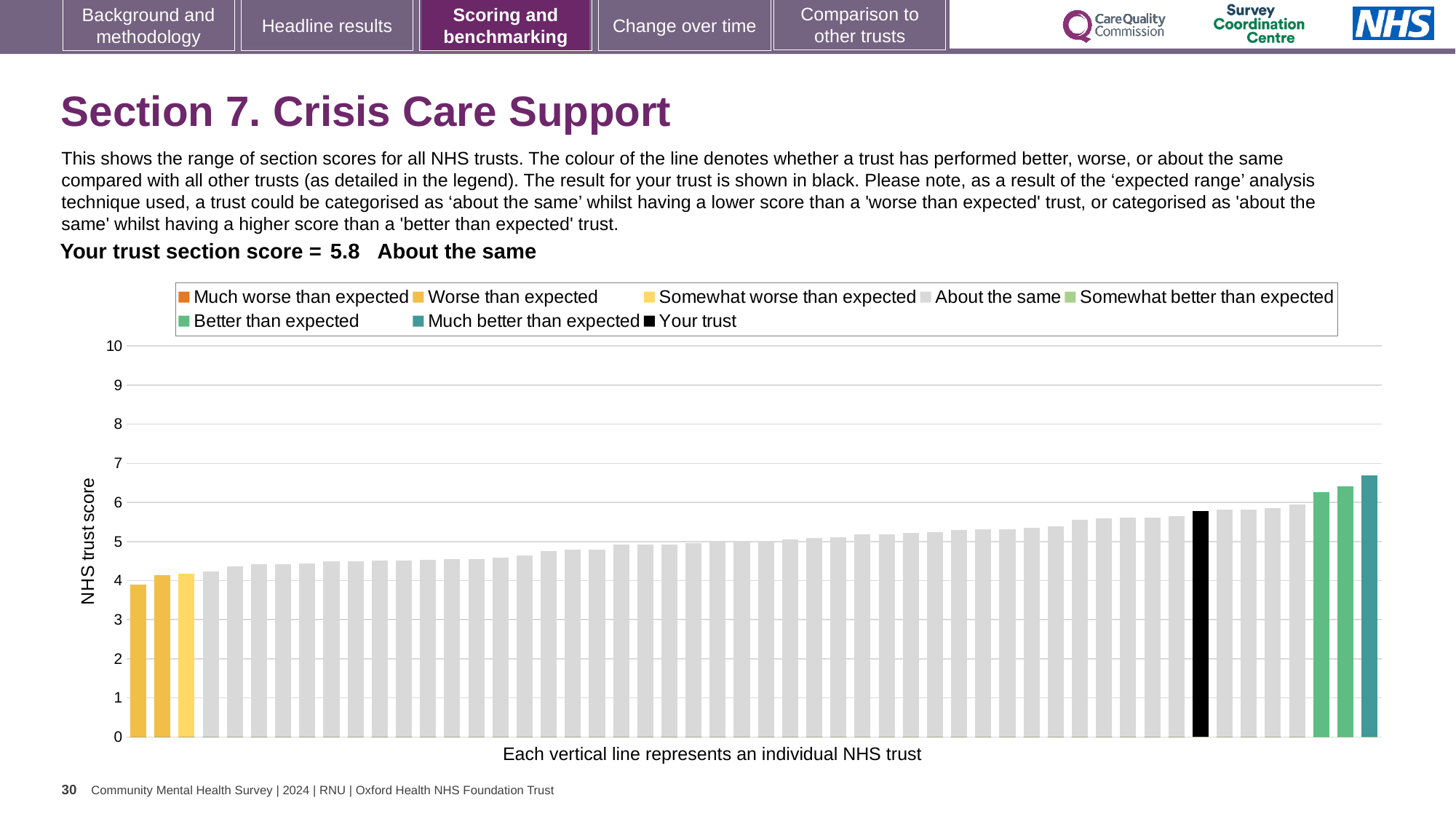
What colour is the bar representing your trust? Black Is the value of the highest bar greater or less than 6? greater How many bars are coloured teal (Much better than expected)? 1 How many entries does the chart legend list? 8 What is the section score for your trust shown on the slide? 5.8 Which is larger: the value for your trust or the value of the rightmost bar? The rightmost bar What kind of chart is shown on the slide? Bar chart What is the label on the y axis of the chart? NHS trust score Which category is your trust's section score placed in? About the same Is the value for your trust greater or less than 5? greater Do the bar values rise or fall from left to right along the x axis? Rise Is the value of the lowest bar greater or less than 5? less